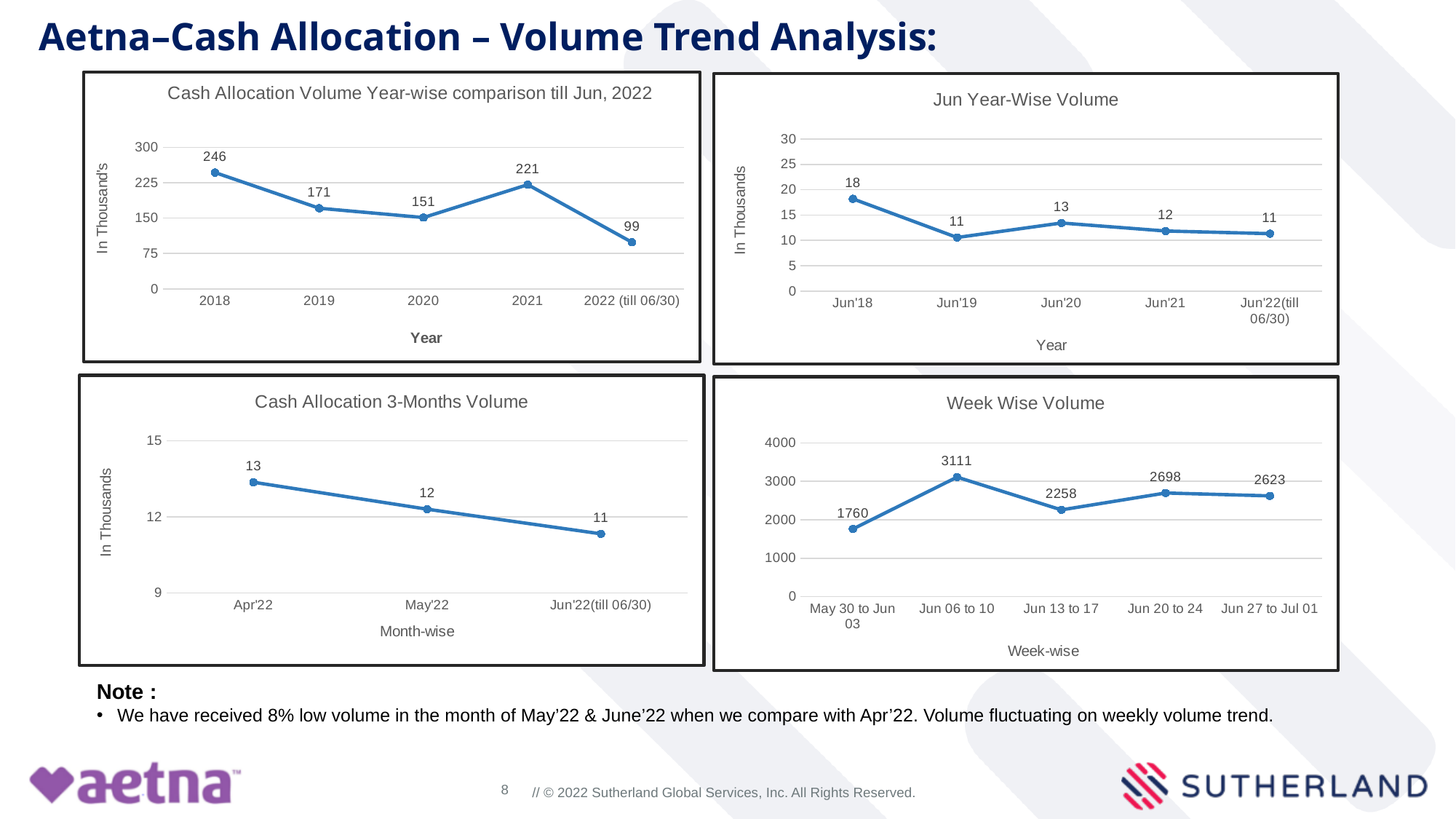
In the 'Cash Allocation Volume Year-wise comparison till Jun, 2022' chart, which year has the lowest value? 2022 (till 06/30) In the 'Jun Year-Wise Volume' chart, what is the value for Jun'20? 13 In the 'Cash Allocation 3-Months Volume' chart, do the values rise or fall from Apr'22 to Jun'22(till 06/30)? fall In the 'Week Wise Volume' chart, is the value for Jun 20 to 24 larger or smaller than the value for Jun 27 to Jul 01? larger In the 'Cash Allocation Volume Year-wise comparison till Jun, 2022' chart, what is the value for 2018? 246 In the 'Jun Year-Wise Volume' chart, how many data points are plotted? 5 In the 'Cash Allocation Volume Year-wise comparison till Jun, 2022' chart, what is the difference between the 2021 and 2020 values? 70 In the 'Week Wise Volume' chart, which week has the highest value? Jun 06 to 10 What type of chart is the 'Week Wise Volume' chart? line chart In the 'Cash Allocation 3-Months Volume' chart, what is the value for May'22? 12 In the 'Jun Year-Wise Volume' chart, which year has the highest value? Jun'18 In the 'Week Wise Volume' chart, what is the value for the week Jun 13 to 17? 2258